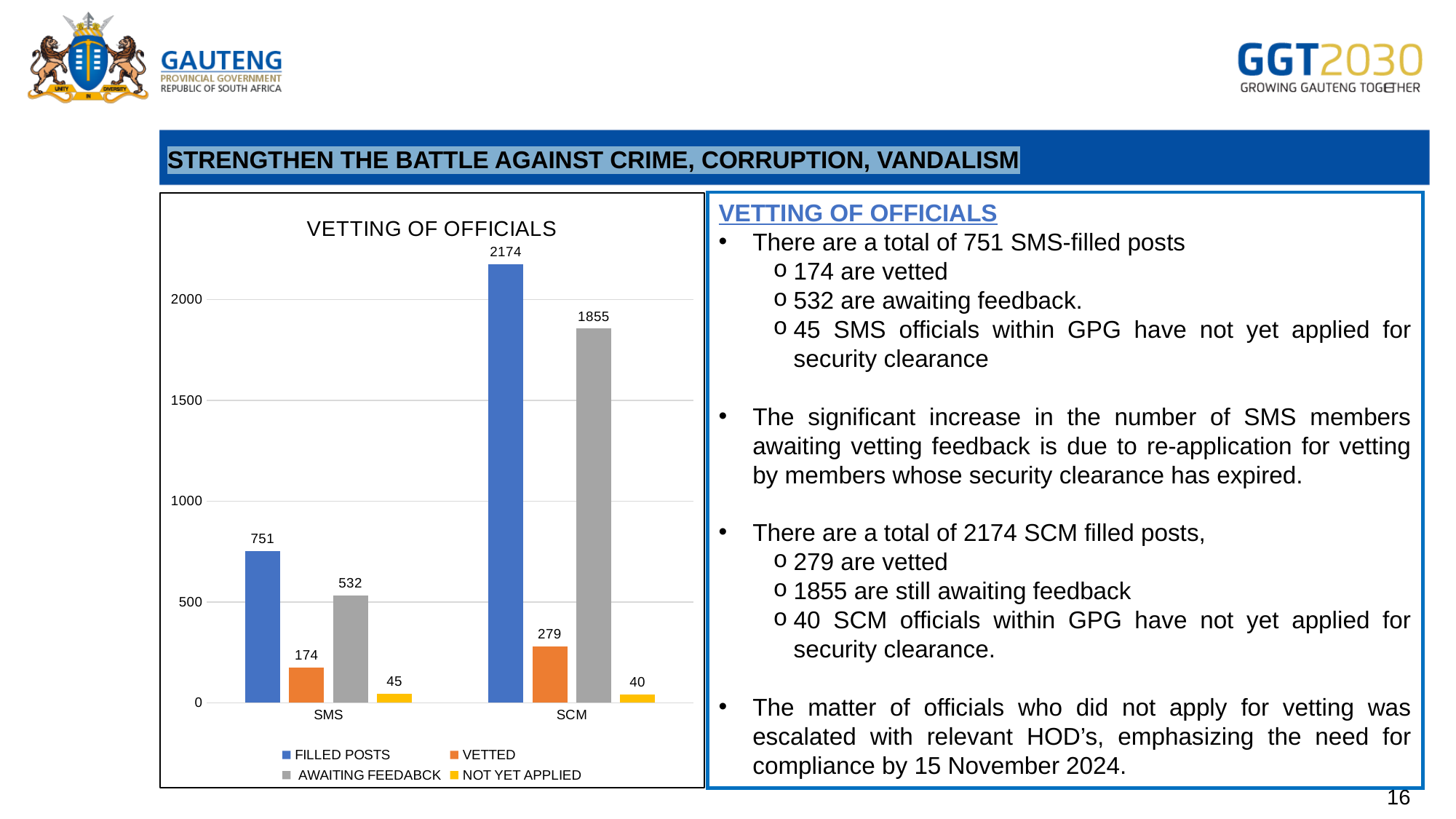
What kind of chart is shown? Bar chart What is the value of VETTED for SMS? 174 How many series does the legend list? 4 How many categories are shown on the x axis? 2 What is the value of FILLED POSTS for SCM? 2174 Which is larger: VETTED for SCM or AWAITING FEEDABCK for SMS? AWAITING FEEDABCK for SMS What is the title of the chart? VETTING OF OFFICIALS What is the value of NOT YET APPLIED for SMS? 45 What is the difference between FILLED POSTS for SCM and FILLED POSTS for SMS? 1423 Which series has the lowest value for SCM? NOT YET APPLIED Which category has the highest FILLED POSTS value? SCM What is the value of AWAITING FEEDABCK for SCM? 1855